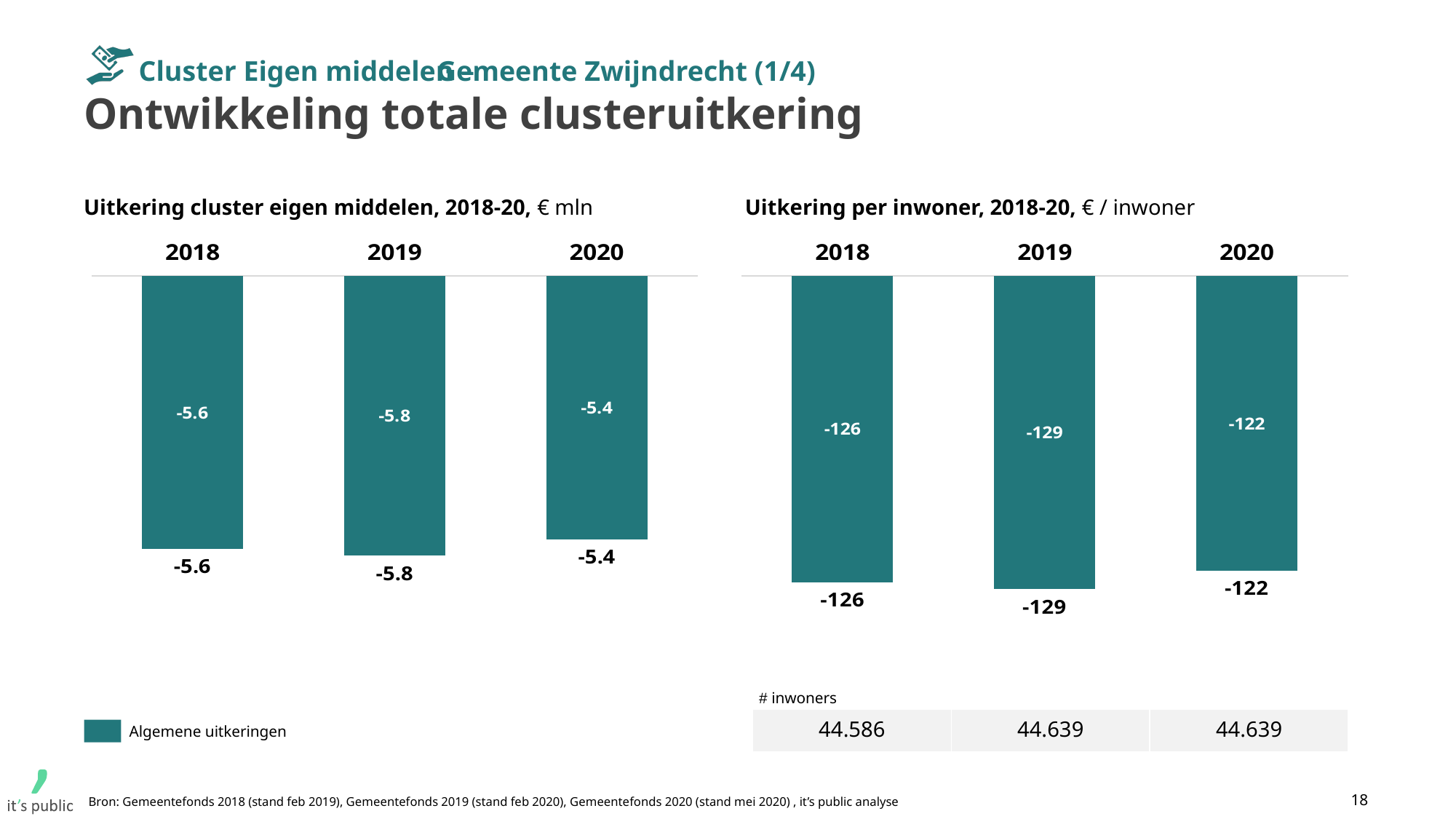
In the chart 'Uitkering cluster eigen middelen, 2018-20', what is the difference between the 2018 value and the 2020 value? 0.2 In the chart 'Uitkering per inwoner, 2018-20', is the value for 2018 or 2019 more negative? 2019 In the chart 'Uitkering per inwoner, 2018-20', what is the value for 2019? -129 What is the legend entry shown below the chart 'Uitkering cluster eigen middelen, 2018-20'? Algemene uitkeringen In the chart 'Uitkering per inwoner, 2018-20', which year has the highest (least negative) value? 2020 In the chart 'Uitkering per inwoner, 2018-20', what is the value for 2018? -126 In the chart 'Uitkering cluster eigen middelen, 2018-20', what is the value for 2020? -5.4 What type of chart is 'Uitkering per inwoner, 2018-20'? Bar chart In the chart 'Uitkering cluster eigen middelen, 2018-20', which year has the lowest (most negative) value? 2019 In the chart 'Uitkering per inwoner, 2018-20', what is the difference between the 2019 value and the 2020 value? 7 How many years are shown in the chart 'Uitkering cluster eigen middelen, 2018-20'? 3 In the chart 'Uitkering cluster eigen middelen, 2018-20', what is the value for 2019? -5.8